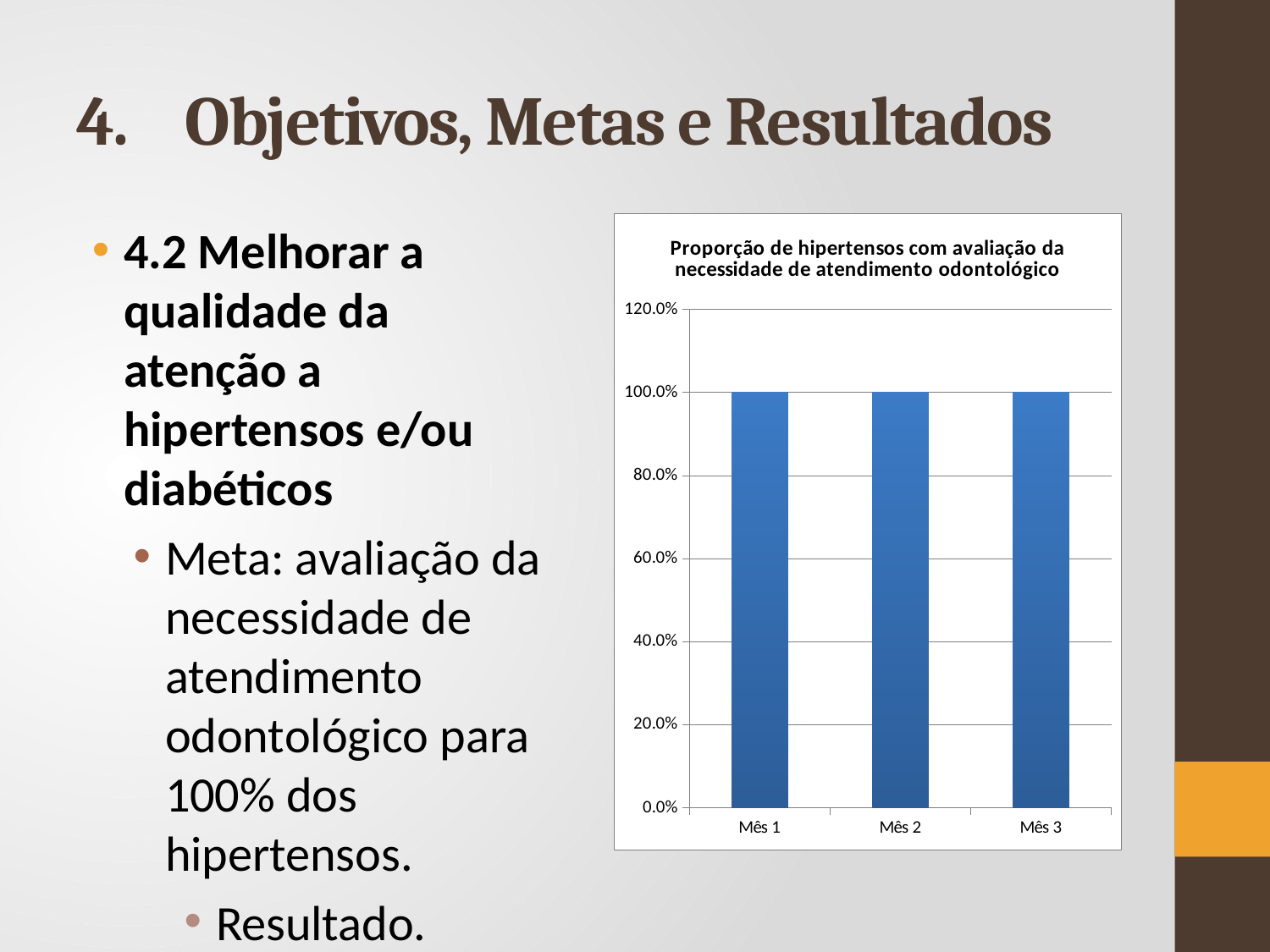
How many categories (months) are shown on the x axis of the chart? 3 What is the value for Mês 1? 100.0% Is the value for Mês 2 greater or less than 80.0%? greater Is the value for Mês 3 greater or less than 120.0%? less What is the value for Mês 3? 100.0% Do the values rise, fall, or stay the same from Mês 1 to Mês 3? stay the same What is the title of the chart? Proporção de hipertensos com avaliação da necessidade de atendimento odontológico What is the difference between the values for Mês 1 and Mês 3? 0.0% What kind of chart is shown on the slide? bar chart What is the highest value shown on the y axis of the chart? 120.0% What is the value for Mês 2? 100.0%